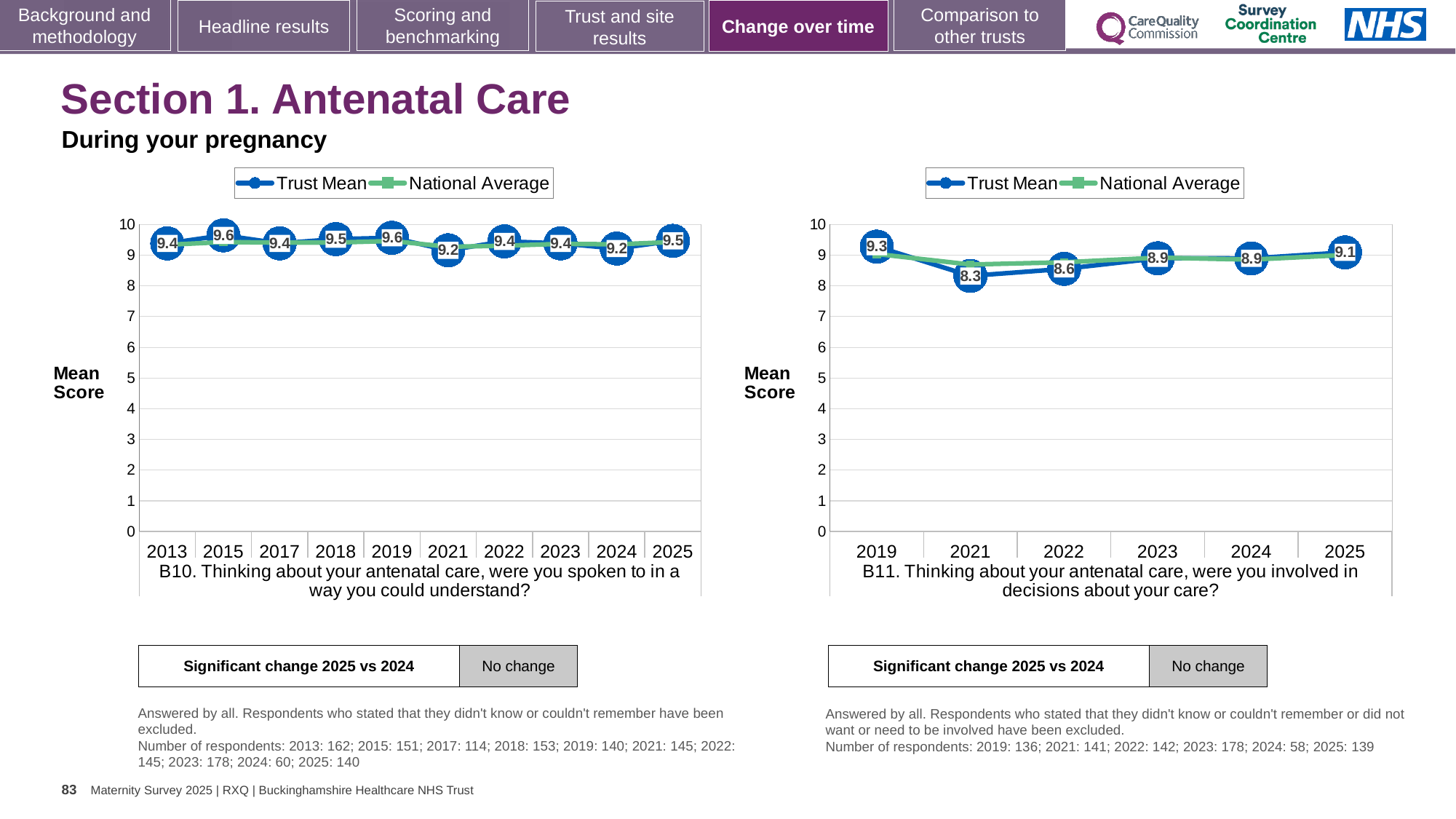
What type of chart is the B11 chart (right)? Line chart On the B10 chart (left), is the Trust Mean for 2019 larger or smaller than the Trust Mean for 2021? larger On the B11 chart (right), what is the Trust Mean for 2025? 9.1 On the B11 chart (right), which year has the lowest Trust Mean? 2021 On the B11 chart (right), what is the Trust Mean for 2021? 8.3 On the B11 chart (right), what is the difference between the Trust Mean for 2019 and 2021? 1.0 On the B10 chart (left), what is the difference between the Trust Mean for 2025 and 2024? 0.3 On the B11 chart (right), which year has the highest Trust Mean? 2019 How many years are plotted on the B11 chart (right)? 6 On the B10 chart (left), what is the Trust Mean for 2021? 9.2 How many series does the legend of the B10 chart (left) list? 2 On the B10 chart (left), what is the Trust Mean for 2025? 9.5